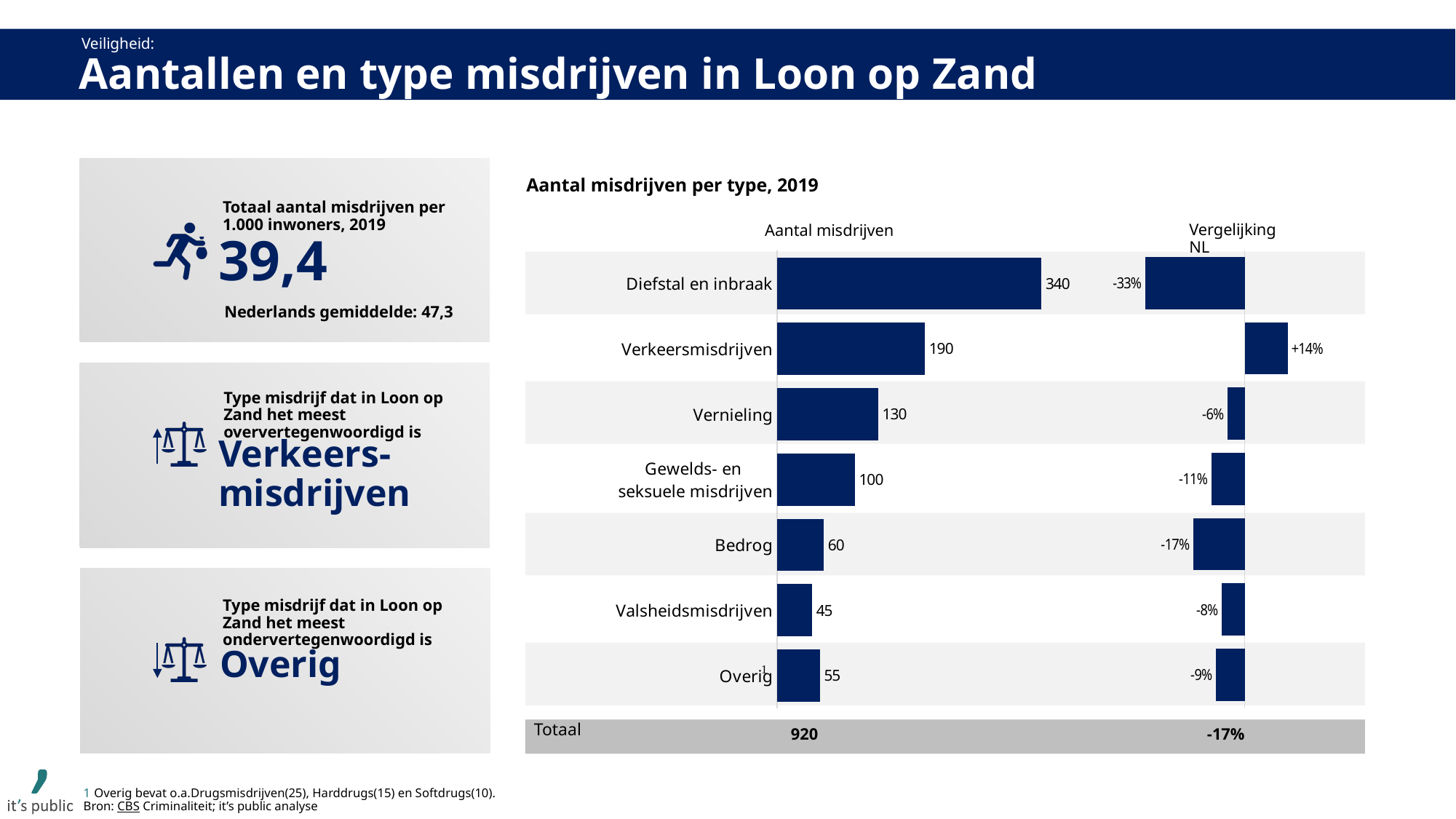
In the chart 'Aantal misdrijven per type, 2019', what is the Vergelijking NL value for Verkeersmisdrijven? +14% What kind of chart is 'Aantal misdrijven per type, 2019'? Bar chart In the chart 'Aantal misdrijven per type, 2019', what is the Totaal Vergelijking NL value? -17% In the chart 'Aantal misdrijven per type, 2019', what is the Vergelijking NL value for Bedrog? -17% In the chart 'Aantal misdrijven per type, 2019', which crime type has the highest Aantal misdrijven? Diefstal en inbraak In the chart 'Aantal misdrijven per type, 2019', what is the difference in Aantal misdrijven between Diefstal en inbraak and Verkeersmisdrijven? 150 In the chart 'Aantal misdrijven per type, 2019', which crime type has the lowest Aantal misdrijven? Valsheidsmisdrijven In the chart 'Aantal misdrijven per type, 2019', which has a higher Aantal misdrijven: Bedrog or Overig? Bedrog In the chart 'Aantal misdrijven per type, 2019', what is the Aantal misdrijven for Diefstal en inbraak? 340 In the chart 'Aantal misdrijven per type, 2019', what is the Totaal Aantal misdrijven? 920 In the chart 'Aantal misdrijven per type, 2019', how many crime types are shown (excluding the Totaal row)? 7 In the chart 'Aantal misdrijven per type, 2019', what is the Aantal misdrijven for Gewelds- en seksuele misdrijven? 100